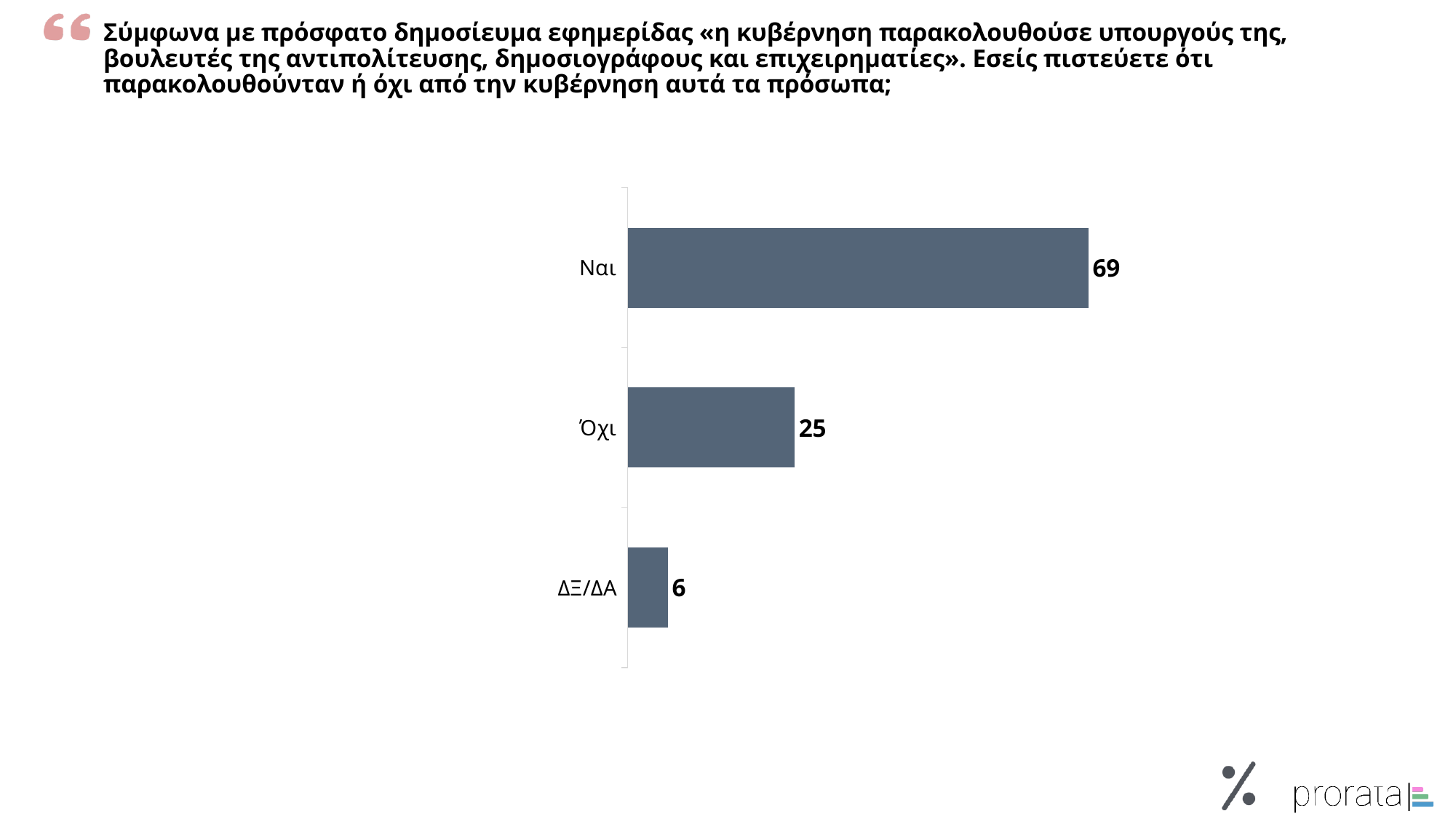
What is the total of the three values shown in the chart? 100 What is the value for Ναι? 69 How many categories are shown in the chart? 3 Which category has the highest value? Ναι What is the difference between the values for Όχι and ΔΞ/ΔΑ? 19 What is the value for ΔΞ/ΔΑ? 6 What colour are the bars in the chart? dark grey-blue What is the difference between the values for Ναι and Όχι? 44 Which is larger, the value for Όχι or the value for ΔΞ/ΔΑ? Όχι Which category has the lowest value? ΔΞ/ΔΑ What kind of chart is shown on the slide? bar chart What is the value for Όχι? 25